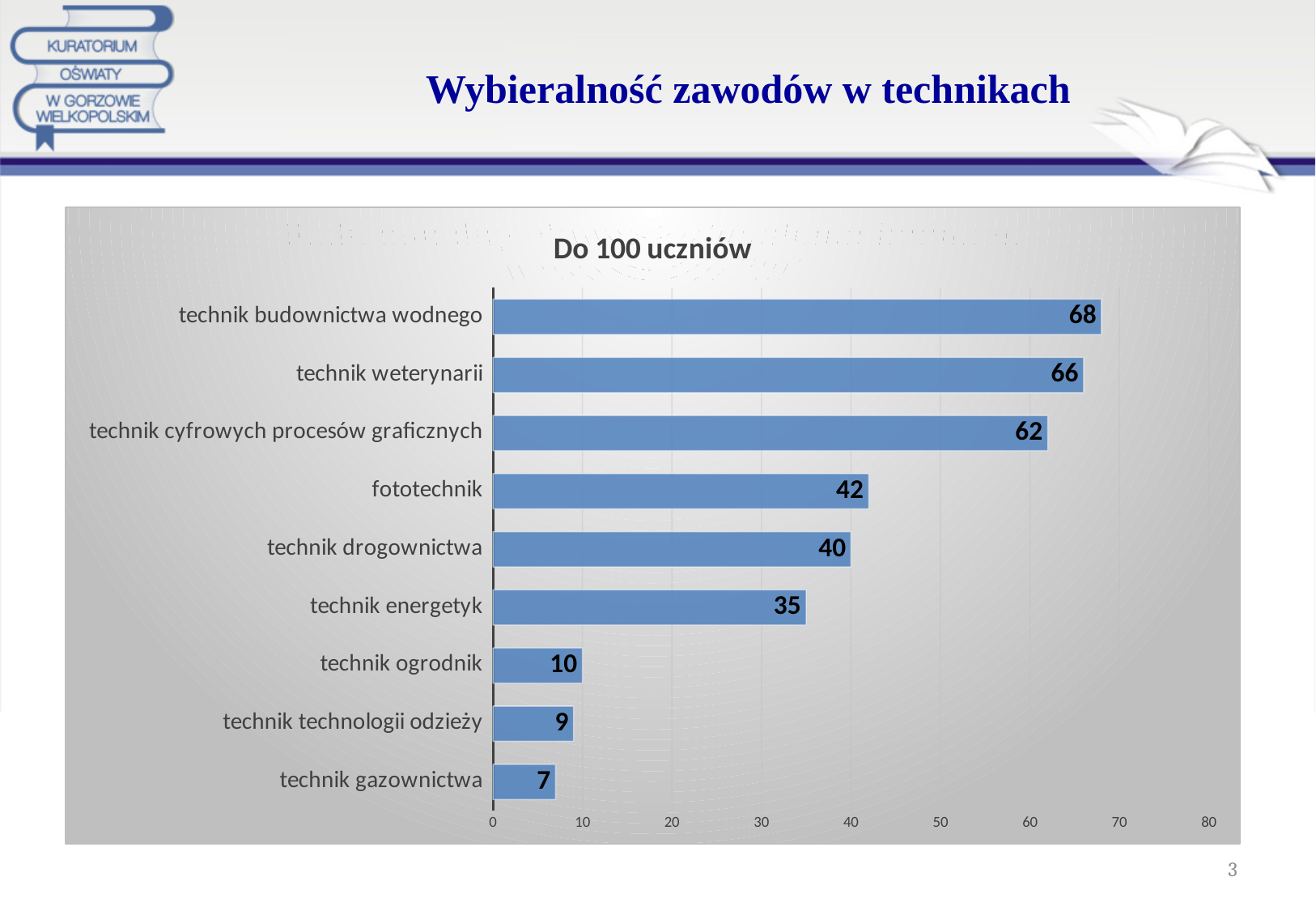
How many categories are shown in the chart? 9 What is the value for fototechnik? 42 What kind of chart is shown on the slide? bar chart What is the highest value shown on the horizontal axis? 80 Which category has the lowest value? technik gazownictwa What is the value for technik weterynarii? 66 Which category has the highest value? technik budownictwa wodnego What is the value for technik technologii odzieży? 9 Which is larger, the value for technik drogownictwa or the value for technik energetyk? technik drogownictwa What is the title of the chart? Do 100 uczniów Is the value for technik ogrodnik greater or less than 20? less What is the difference between the values for technik budownictwa wodnego and technik cyfrowych procesów graficznych? 6